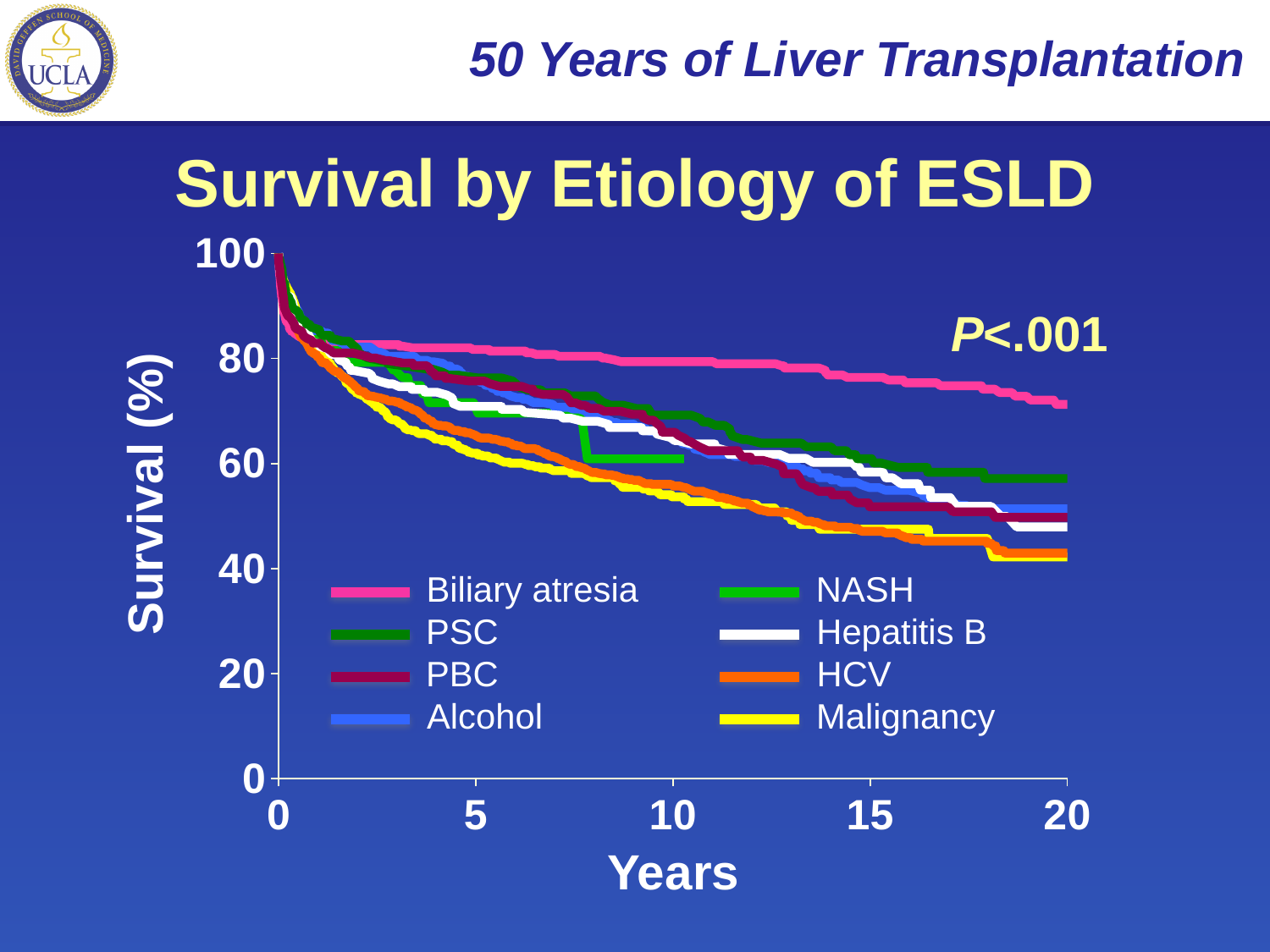
Do the survival curves rise or fall as years increase? Fall How many series does the legend list? 8 Which etiology has the highest survival at 20 years? Biliary atresia What kind of chart is shown on the slide? Line chart What is the title of the chart? Survival by Etiology of ESLD Is the survival for Biliary atresia at 10 years greater or less than 60? greater Is the survival for Biliary atresia at 20 years greater or less than 60? greater What is the label of the y axis? Survival (%) At 20 years, which has higher survival: PSC or HCV? PSC Is the survival for Malignancy at 20 years greater or less than 60? less At 15 years, which has higher survival: Biliary atresia or Malignancy? Biliary atresia